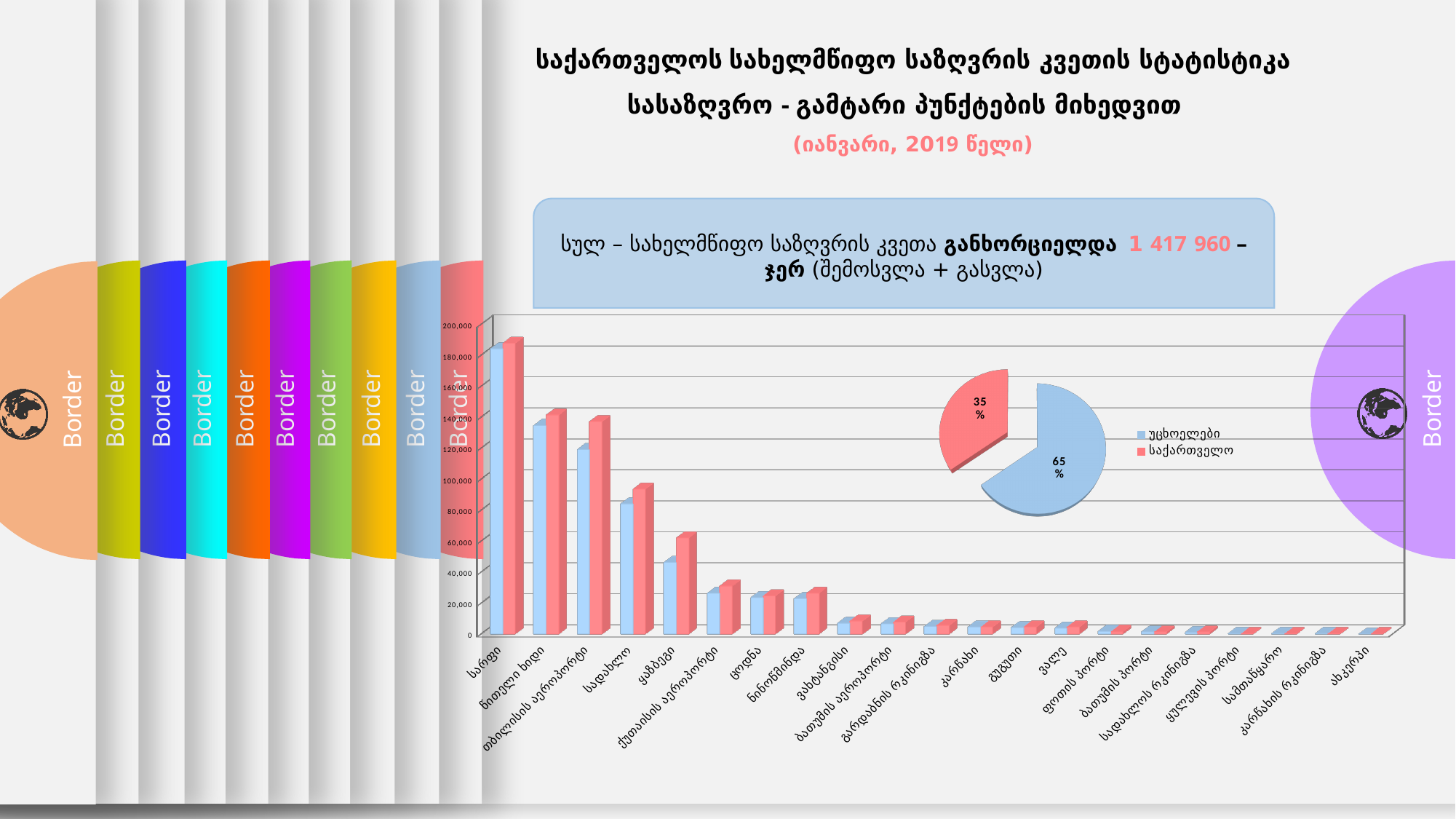
In the bar chart, do the values generally rise or fall moving from left to right along the x axis? fall In the bar chart, is the blue bar for სარფი greater or less than 160,000? greater What kind of chart is the small chart on the right side of the slide? pie chart How many categories are shown on the x axis of the bar chart? 21 In the pie chart, what share is labelled for the red slice (საქართველო)? 35% In the bar chart, is the red bar for ყაზბეგი greater or less than 40,000? greater In the pie chart, which slice is larger, უცხოელები or საქართველო? უცხოელები In the pie chart, what share is labelled for the blue slice (უცხოელები)? 65% How many series does the legend of the pie chart list? 2 In the pie chart, what is the difference in percentage points between the უცხოელები slice and the საქართველო slice? 30 What kind of chart is the large chart at the bottom of the slide? bar chart In the bar chart, which category has the highest bars? სარფი